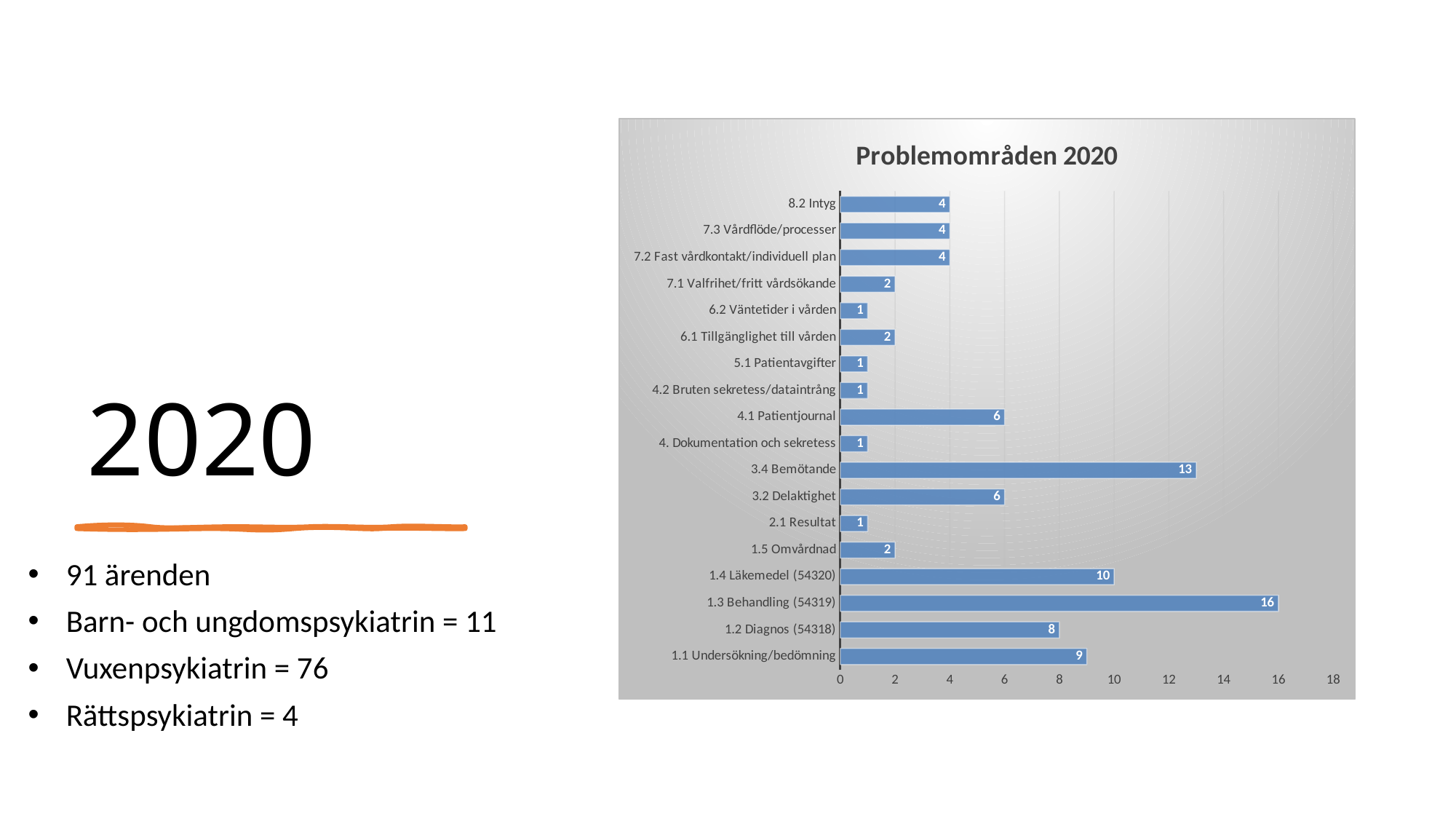
Which category has the highest value? 1.3 Behandling (54319) What is the value for 1.4 Läkemedel (54320)? 10 What is the value for 3.4 Bemötande? 13 How many categories are shown in the chart? 18 What is the value for 1.1 Undersökning/bedömning? 9 What is the title of the chart? Problemområden 2020 What kind of chart is shown on the slide? Bar chart What is the value for 4.1 Patientjournal? 6 What is the difference between the values for 1.3 Behandling (54319) and 1.2 Diagnos (54318)? 8 What is the difference between the values for 3.4 Bemötande and 3.2 Delaktighet? 7 Is the value for 3.4 Bemötande greater or less than 12? greater Which is larger, the value for 1.4 Läkemedel (54320) or the value for 1.1 Undersökning/bedömning? 1.4 Läkemedel (54320)